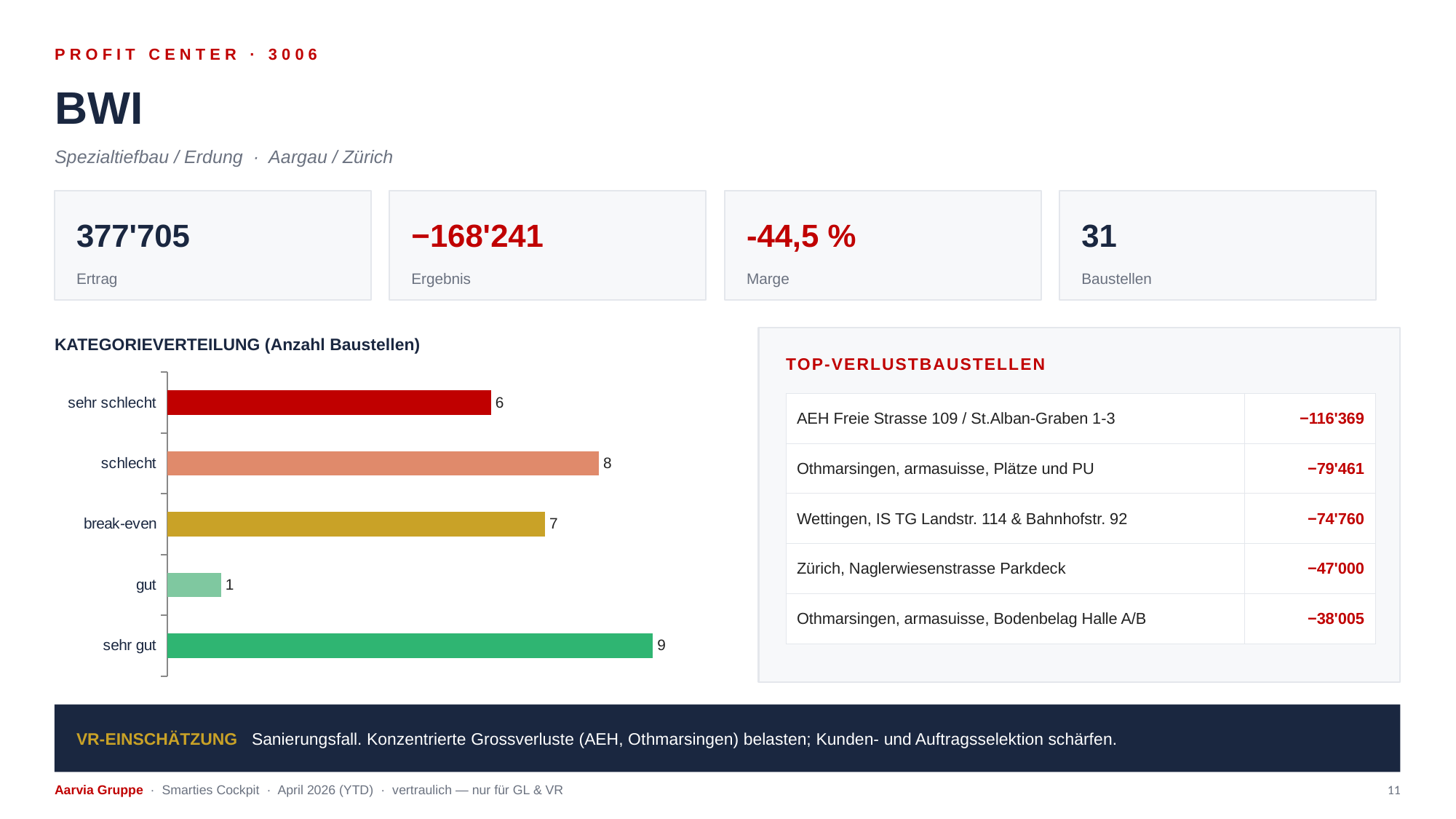
In the KATEGORIEVERTEILUNG chart, what is the value for 'schlecht'? 8 In the KATEGORIEVERTEILUNG chart, what is the value for 'break-even'? 7 In the KATEGORIEVERTEILUNG chart, how many Baustellen are in the 'sehr schlecht' category? 6 In the KATEGORIEVERTEILUNG chart, what is the value for 'gut'? 1 In the KATEGORIEVERTEILUNG chart, which is larger: 'schlecht' or 'break-even'? schlecht How many categories does the KATEGORIEVERTEILUNG chart show? 5 What colour is the 'sehr schlecht' bar in the KATEGORIEVERTEILUNG chart? red What kind of chart is the KATEGORIEVERTEILUNG chart? bar chart In the KATEGORIEVERTEILUNG chart, which category has the lowest number of Baustellen? gut In the KATEGORIEVERTEILUNG chart, which category has the highest number of Baustellen? sehr gut In the KATEGORIEVERTEILUNG chart, what is the combined number of Baustellen in 'sehr schlecht' and 'schlecht'? 14 In the KATEGORIEVERTEILUNG chart, what is the difference between the 'sehr gut' and 'gut' values? 8